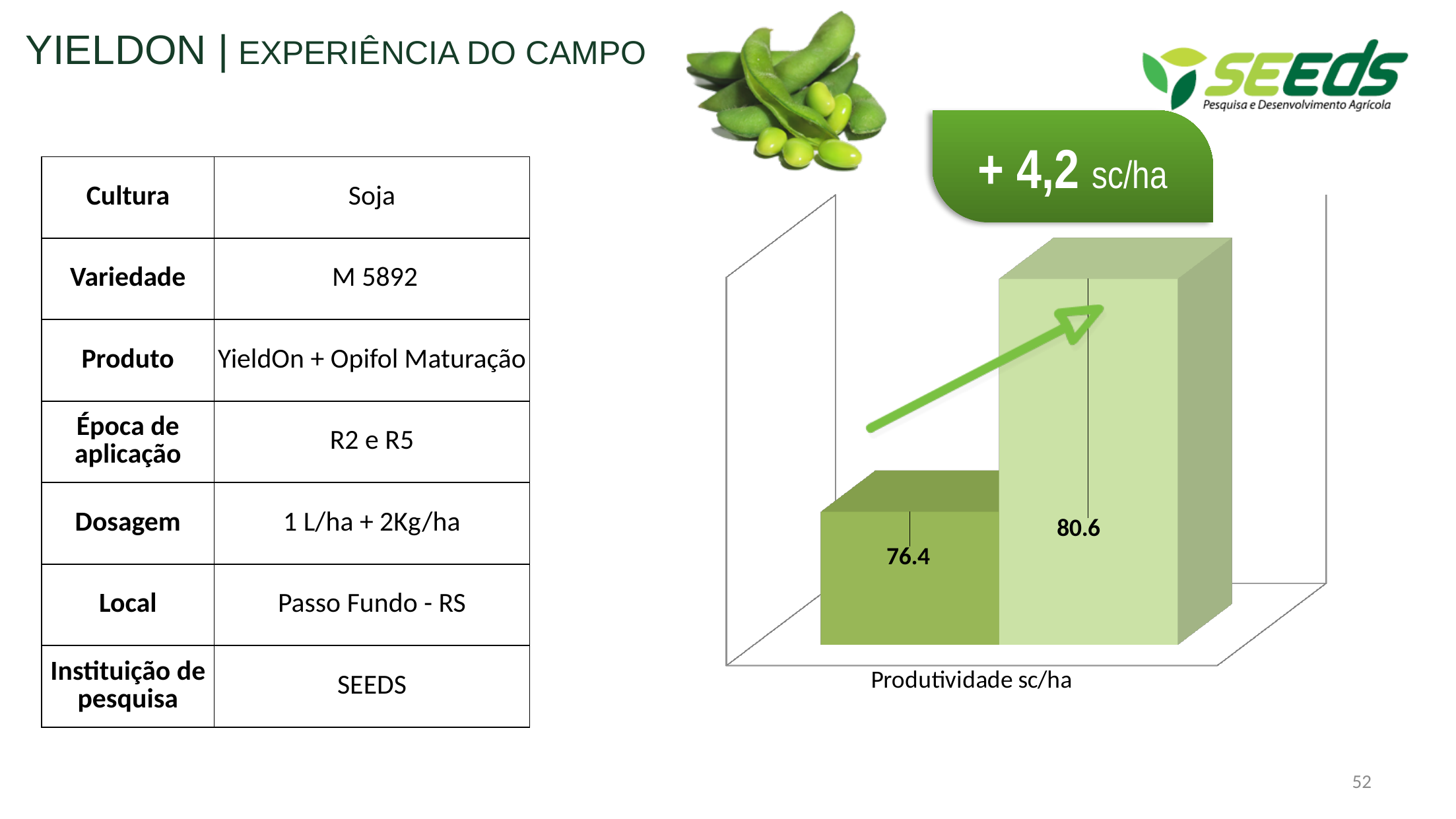
Which bar in the chart has the lowest value, the left or the right one? the left bar (76.4) What value is printed on the left (darker green) bar of the chart? 76.4 What is the difference between the values of the right bar and the left bar in the chart? 4.2 Is the value of the right bar larger or smaller than the value of the left bar? larger Which bar in the chart has the highest value, the left or the right one? the right bar (80.6) What is the label shown beneath the bars on the chart's horizontal axis? Produtividade sc/ha What value is printed on the right (lighter green) bar of the chart? 80.6 How many bars are plotted in the chart? 2 What kind of chart is shown on the slide? bar chart What gain is stated in the green callout above the chart? + 4,2 sc/ha